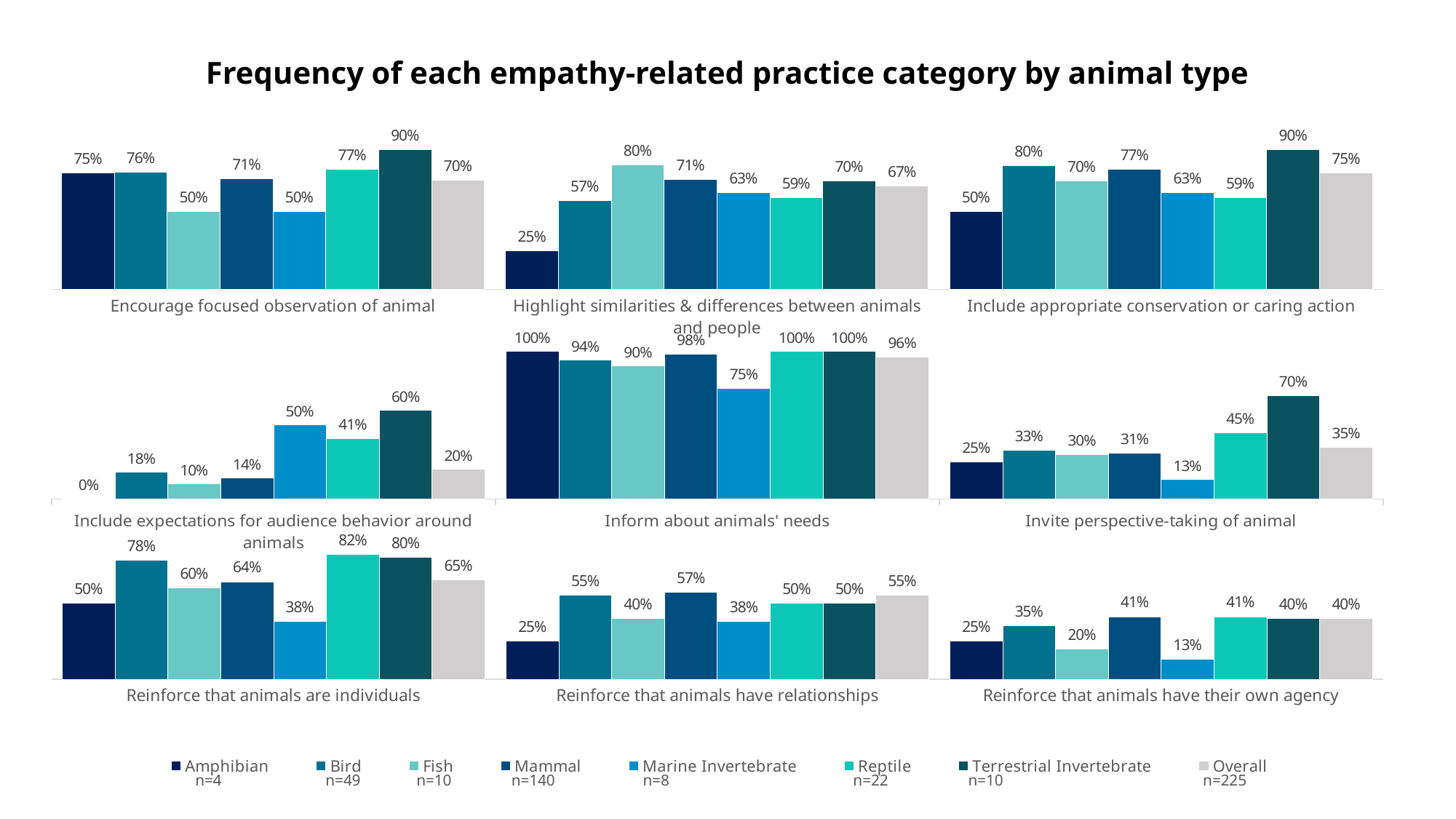
What is the title of the chart? Frequency of each empathy-related practice category by animal type In the "Reinforce that animals have relationships" group, which is larger: the Bird value or the Fish value? Bird Which animal type has the lowest value in the "Include expectations for audience behavior around animals" group? Amphibian What is the value for Amphibian in the "Highlight similarities & differences between animals and people" group? 25% What kind of chart is shown on the slide? Bar chart What is the difference between the Reptile and Marine Invertebrate values in the "Reinforce that animals are individuals" group? 44% What is the sample size (n) shown in the legend for Mammal? n=140 How many series does the legend list? 8 What is the value for Terrestrial Invertebrate in the "Encourage focused observation of animal" group? 90% Which animal type has the highest value in the "Invite perspective-taking of animal" group? Terrestrial Invertebrate What is the Overall value in the "Inform about animals' needs" group? 96% How many practice category groups are shown on the slide? 9